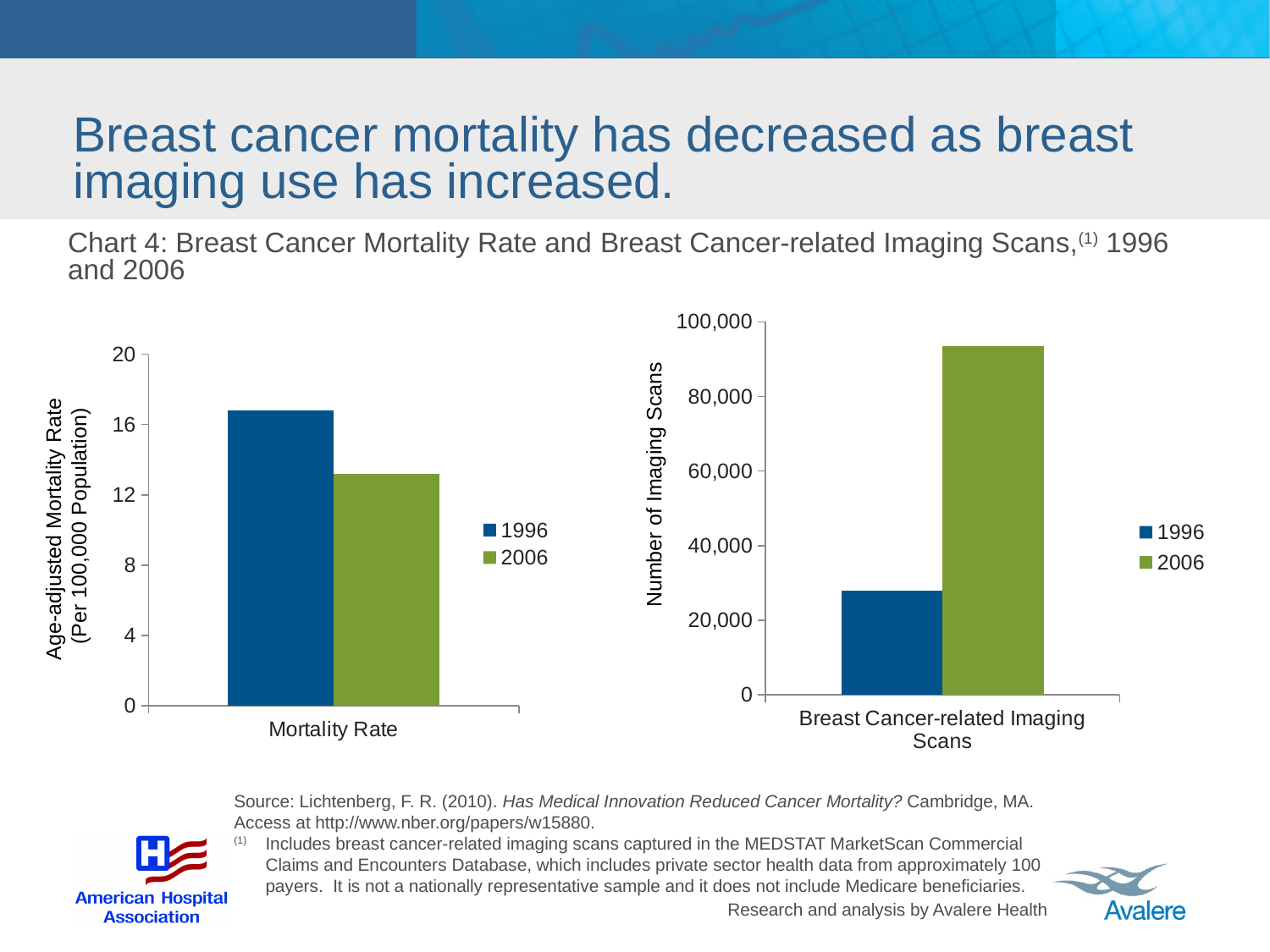
In the left chart (Mortality Rate), which series has the larger value, 1996 or 2006? 1996 How many categories are shown on the x axis of the left chart (Mortality Rate)? 1 In the left chart (Mortality Rate), is the value for 2006 greater or less than 12? greater In the left chart (Mortality Rate), is the value for 2006 greater or less than 16? less In the left chart (Mortality Rate), is the value for 1996 greater or less than 16? greater In the right chart (Breast Cancer-related Imaging Scans), which colour represents 2006 in the legend? green In the right chart (Breast Cancer-related Imaging Scans), which series has the larger value, 1996 or 2006? 2006 What is the y-axis title of the right chart (Breast Cancer-related Imaging Scans)? Number of Imaging Scans What kind of chart is the right chart (Breast Cancer-related Imaging Scans)? bar chart How many series does the legend of the left chart (Mortality Rate) list? 2